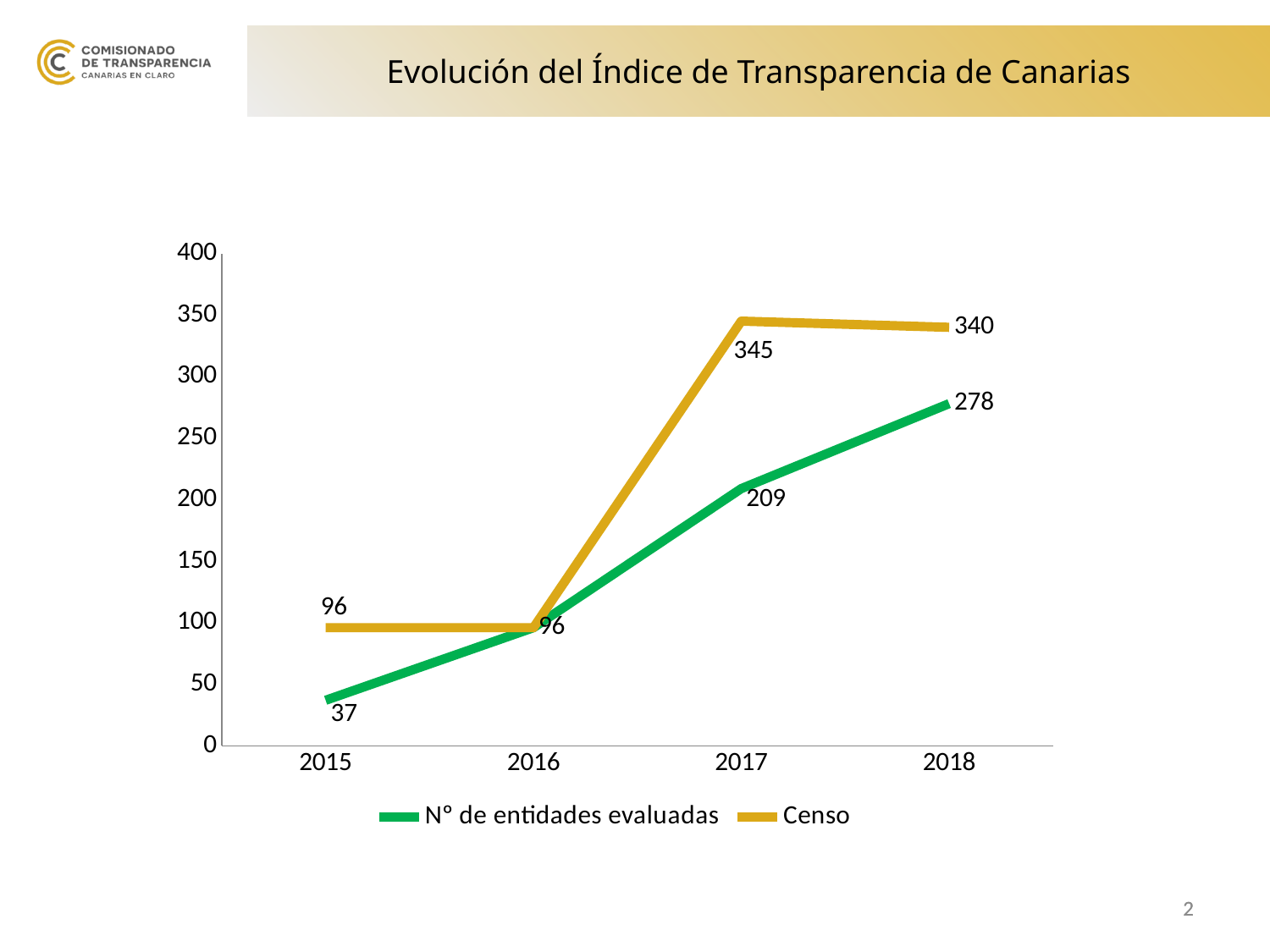
What is the value of Censo in 2018? 340 How many years are plotted along the x axis? 4 In which year is Nº de entidades evaluadas highest? 2018 What is the value of Nº de entidades evaluadas in 2015? 37 How many series does the legend list? 2 What is the value of Censo in 2017? 345 What is the value of Nº de entidades evaluadas in 2018? 278 Does Nº de entidades evaluadas rise or fall from 2015 to 2018? rise What kind of chart is shown on the slide? line chart What is the value of Nº de entidades evaluadas in 2017? 209 What is the difference between Censo and Nº de entidades evaluadas in 2017? 136 Which is larger for Censo: the value in 2017 or the value in 2018? 2017